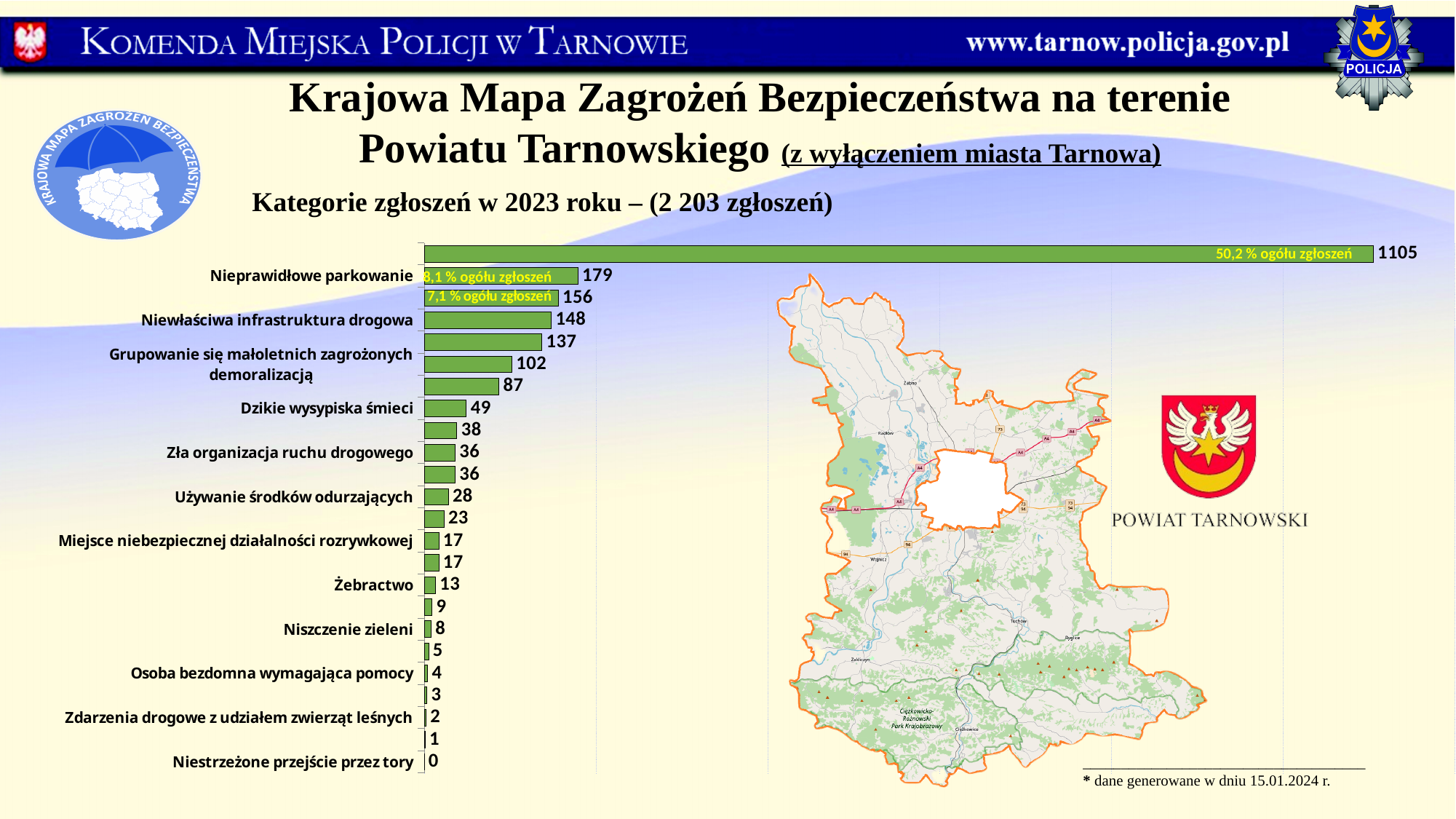
Which is larger, the value for Dzikie wysypiska śmieci or the value for Żebractwo? Dzikie wysypiska śmieci What is the difference between the second-longest bar (179) and the third-longest bar (156)? 23 How many bars are plotted in the chart? 24 What is the value for Dzikie wysypiska śmieci? 49 What is the value for Niszczenie zieleni? 8 What is the value for Żebractwo? 13 What is the value for Osoba bezdomna wymagająca pomocy? 4 What is the value for Niestrzeżone przejście przez tory? 0 What kind of chart is shown on the slide? bar chart Which category has the lowest value in the chart? Niestrzeżone przejście przez tory What percentage of all reports does the longest bar (1105) represent, according to its label? 50,2 % ogółu zgłoszeń What is the value of the longest bar in the chart? 1105